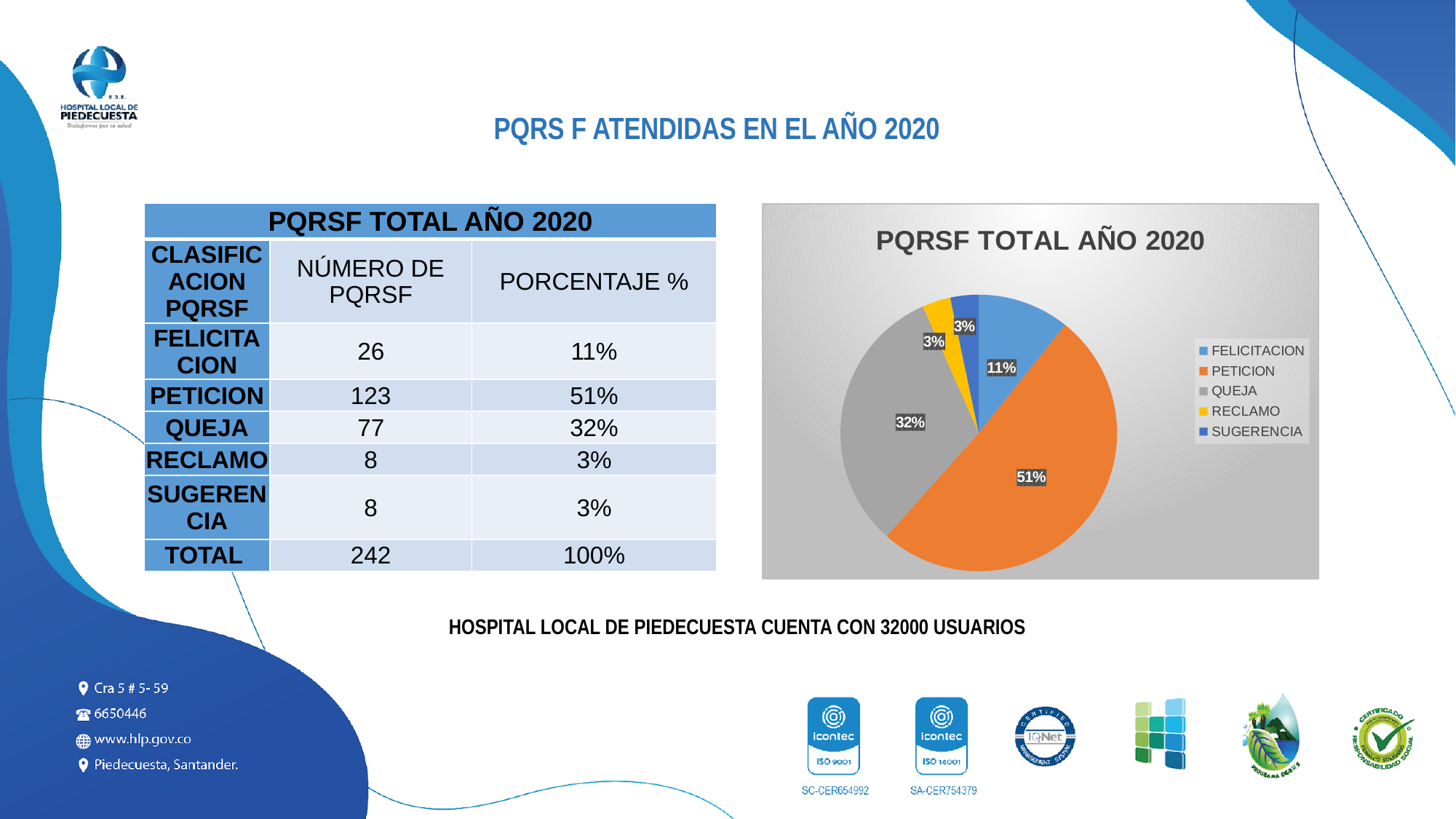
How many series does the chart legend list? 5 What percentage does the FELICITACION slice show? 11% What is the difference in percentage points between the PETICION slice and the QUEJA slice? 19 What percentage does the QUEJA slice show? 32% What percentage does the PETICION slice show? 51% What percentage does the RECLAMO slice show? 3% What is the title of the chart? PQRSF TOTAL AÑO 2020 Which is larger, the QUEJA slice or the FELICITACION slice? QUEJA What colour is the PETICION slice in the chart? orange What type of chart is shown on the slide? pie chart How many slices does the pie chart have? 5 Which category has the largest slice of the pie? PETICION